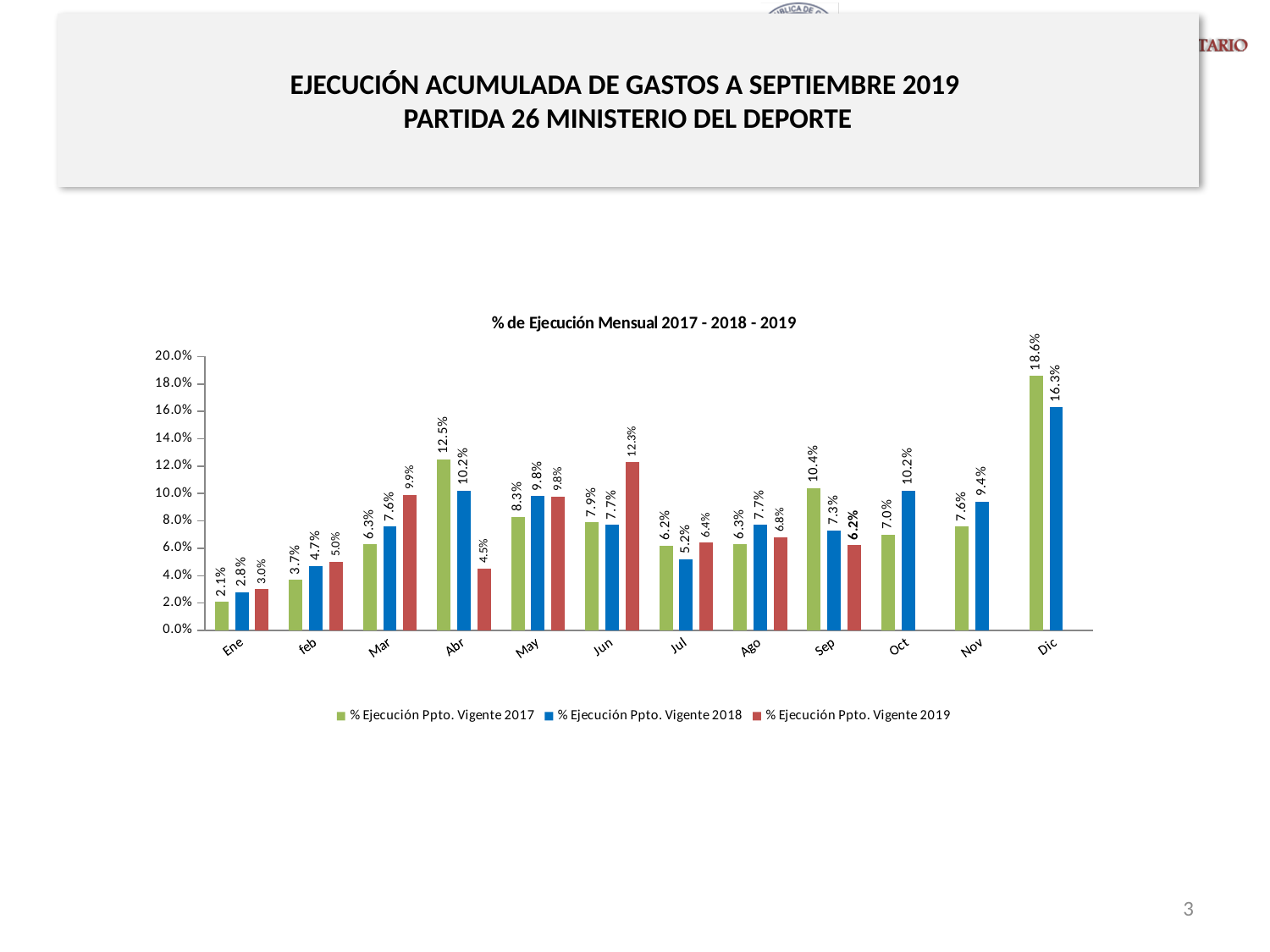
What is the value for % Ejecución Ppto. Vigente 2018 in Dic? 16.3% Is the value for % Ejecución Ppto. Vigente 2019 in Abr greater or less than 6.0%? less Which month has the lowest value for % Ejecución Ppto. Vigente 2019? Ene What kind of chart is shown on the slide? Bar chart What is the difference between the 2017 and 2018 values in Dic? 2.3% How many months are shown on the x axis? 12 What is the value for % Ejecución Ppto. Vigente 2017 in Abr? 12.5% Which is larger in Sep: the 2017 value or the 2019 value? 2017 value Which month has the highest value for % Ejecución Ppto. Vigente 2017? Dic How many series does the legend list? 3 What is the value for % Ejecución Ppto. Vigente 2019 in Jun? 12.3% What is the title of the chart? % de Ejecución Mensual 2017 - 2018 - 2019